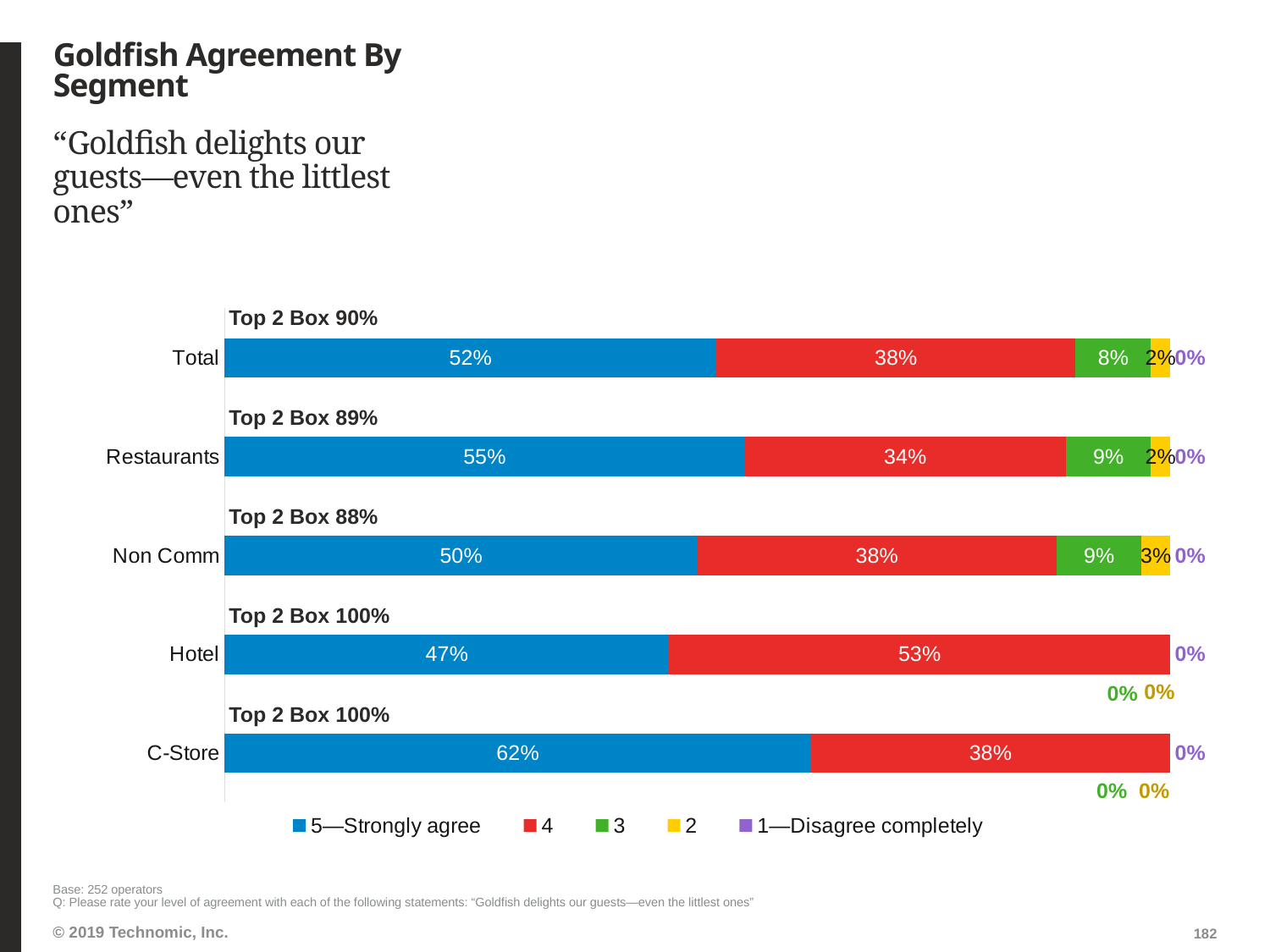
How many segments are shown on the chart? 5 Which segment has the highest "5—Strongly agree" percentage? C-Store What is the difference between the "5—Strongly agree" percentages for C-Store and Hotel? 15% What is the Top 2 Box value shown for Non Comm? 88% What kind of chart is shown on the slide? Stacked bar chart Which segment has the lowest "5—Strongly agree" percentage? Hotel Which is larger: the "4" percentage for Restaurants or for Non Comm? Non Comm What percentage of Restaurants respondents answered "4"? 34% How many series does the legend list? 5 What percentage of Total respondents answered "5—Strongly agree"? 52% What percentage of Hotel respondents answered "4"? 53% What percentage of Non Comm respondents answered "2"? 3%